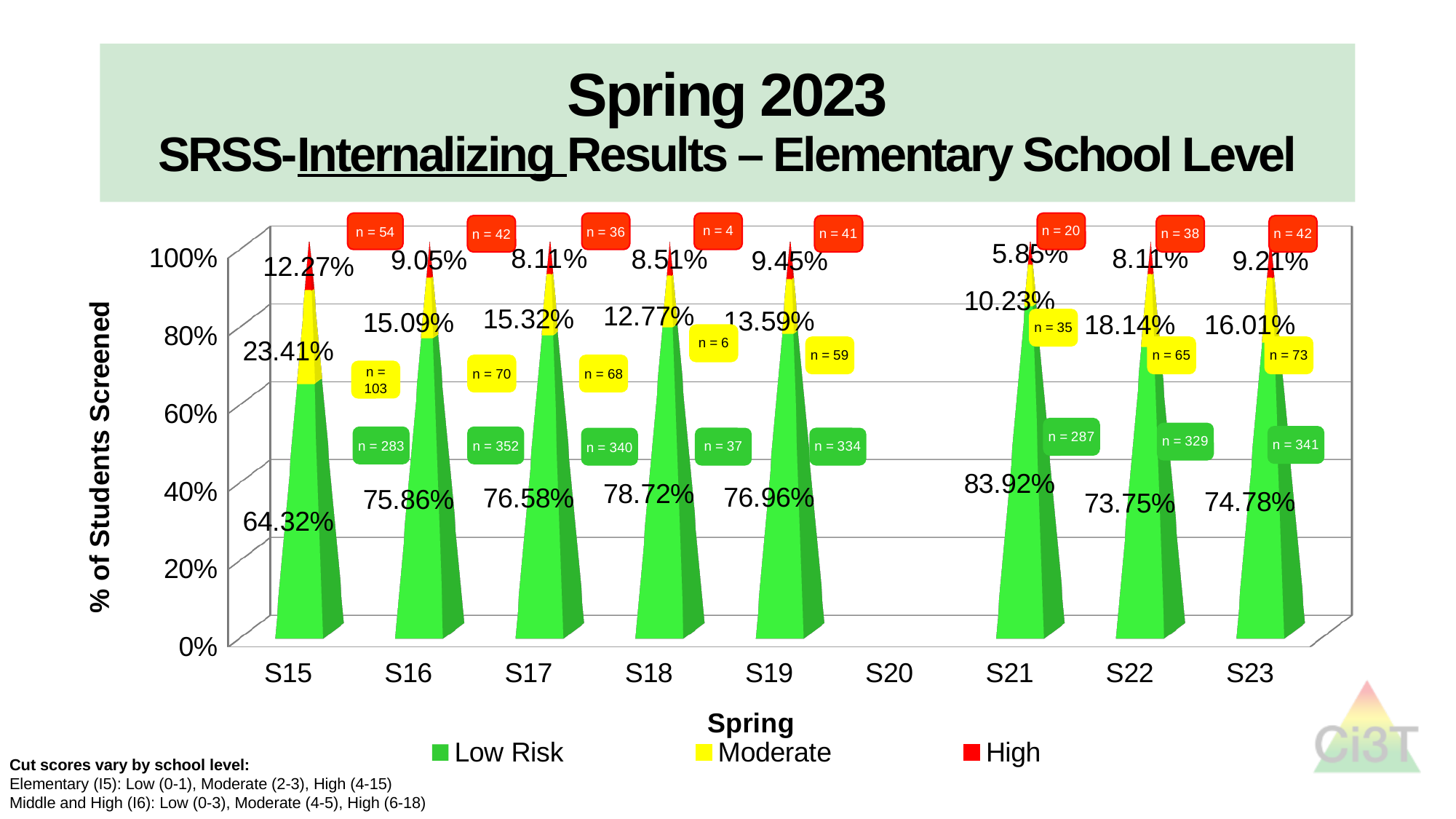
Which spring has the highest High percentage? S15 How many spring categories are labeled on the x axis? 9 What kind of chart is shown? Stacked bar chart What is the High percentage for S21? 5.85% Is the Moderate percentage larger for S15 or for S16? S15 How many series does the legend list? 3 Which spring has the lowest Low Risk percentage? S15 What is the Moderate percentage for S22? 18.14% What is the difference between the Low Risk percentages for S21 and S15? 19.60% Which category on the x axis has no data plotted? S20 What is the Low Risk percentage for S15? 64.32% Which spring has the highest Low Risk percentage? S21